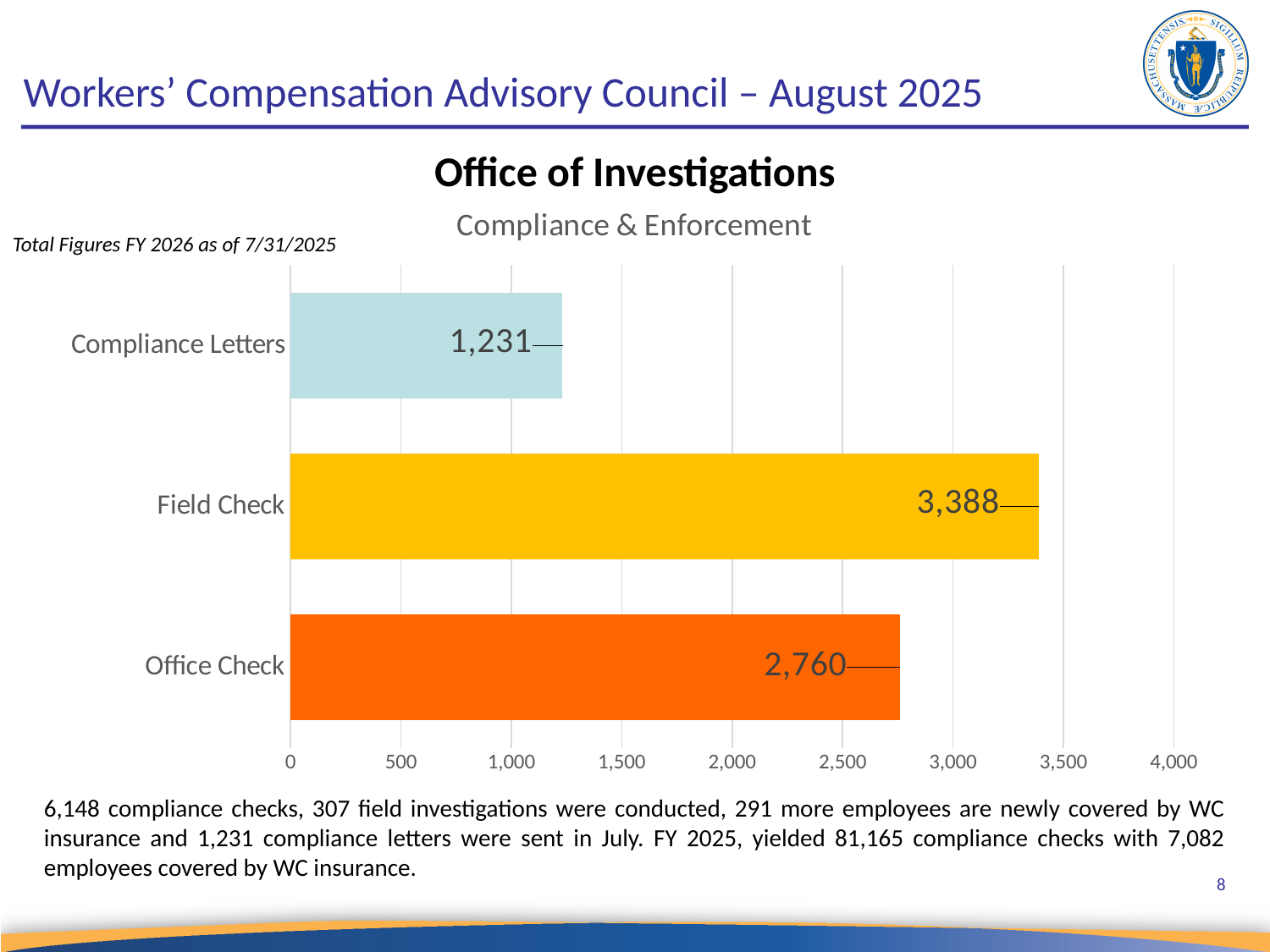
What is the difference between the Field Check and Office Check values? 628 What kind of chart is shown on the slide? Bar chart Is the value for Field Check greater or less than 3,000? greater Which category has the highest value? Field Check How many categories are shown in the chart? 3 Which is larger, Office Check or Compliance Letters? Office Check What is the title of the chart? Compliance & Enforcement What is the value for Compliance Letters? 1,231 Which category has the lowest value? Compliance Letters What is the difference between the Office Check and Compliance Letters values? 1,529 What is the value for Office Check? 2,760 What is the value for Field Check? 3,388